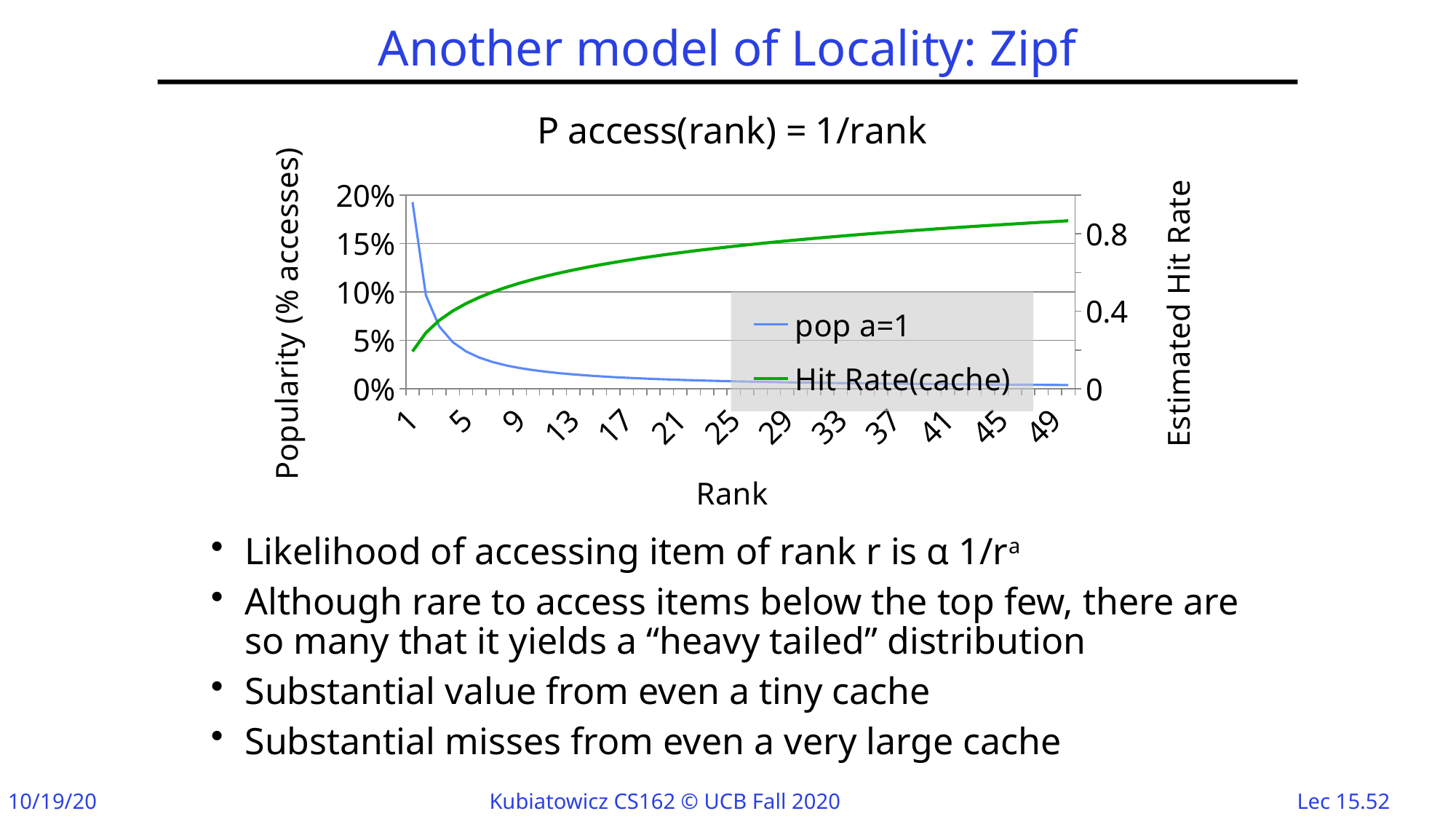
Is the Hit Rate(cache) value at rank 1 greater or less than 0.4? less At which labelled rank is the Hit Rate(cache) series lowest? 1 Does the Hit Rate(cache) series rise or fall as rank increases? rise Does the pop a=1 series rise or fall as rank increases? fall What kind of chart is shown on the slide? line chart Is the pop a=1 value at rank 1 greater or less than 15%? greater At which rank is the pop a=1 series highest? 1 What is the title of the chart? P access(rank) = 1/rank Is the pop a=1 value at rank 9 greater or less than 5%? less What are the two series named in the legend? pop a=1 and Hit Rate(cache) How many series does the chart legend list? 2